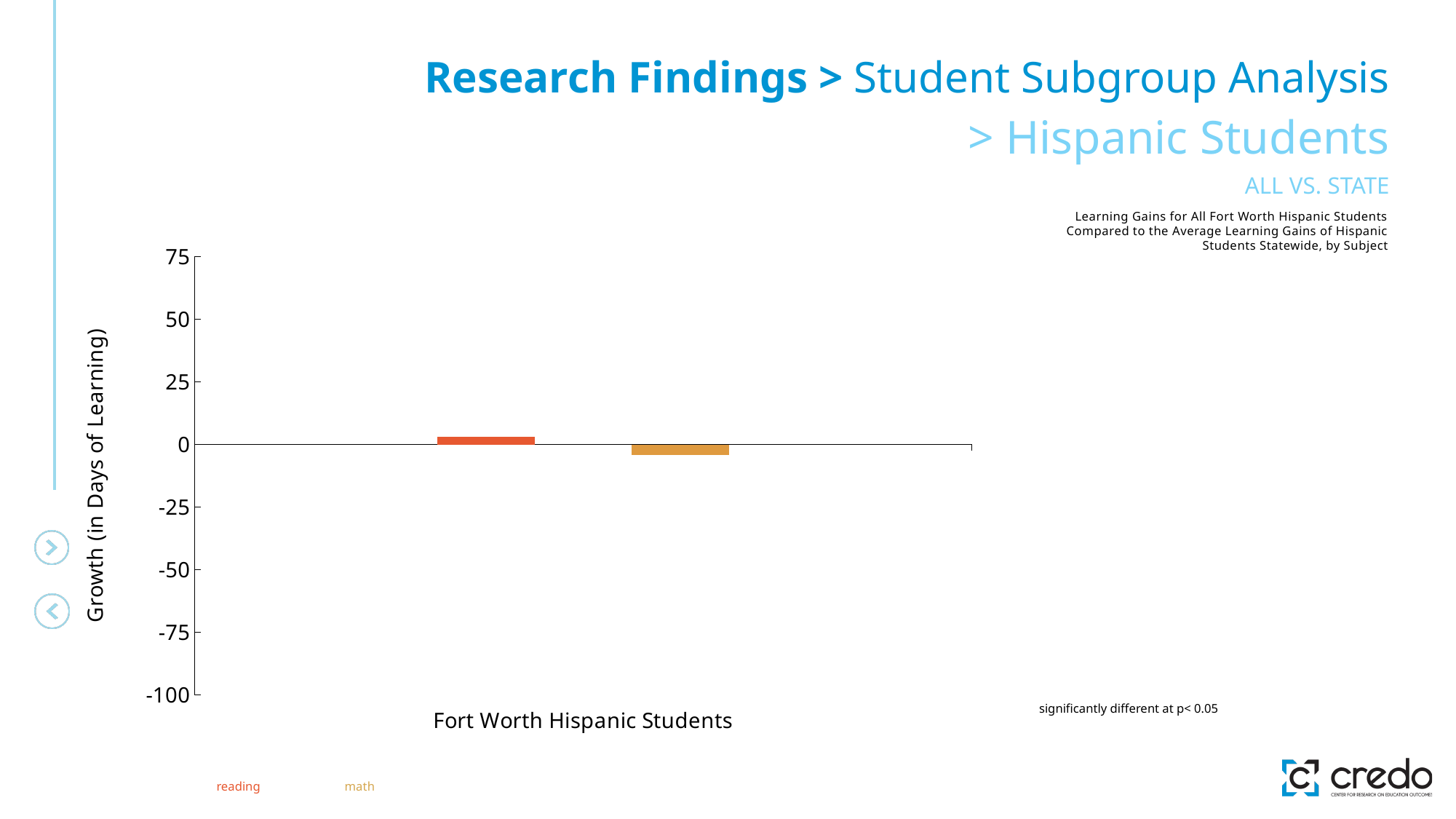
Which series has the higher value for Fort Worth Hispanic Students, reading or math? reading What is the category label on the x axis? Fort Worth Hispanic Students What is the label on the y axis? Growth (in Days of Learning) Is the value for reading greater or less than 0? greater Which series has the lowest value on the chart? math Is the value for math greater or less than -25? greater How many series does the legend list? 2 How many categories are shown on the x axis? 1 Which series has the highest value on the chart? reading What kind of chart is shown on the slide? bar chart Is the value for math greater or less than 0? less